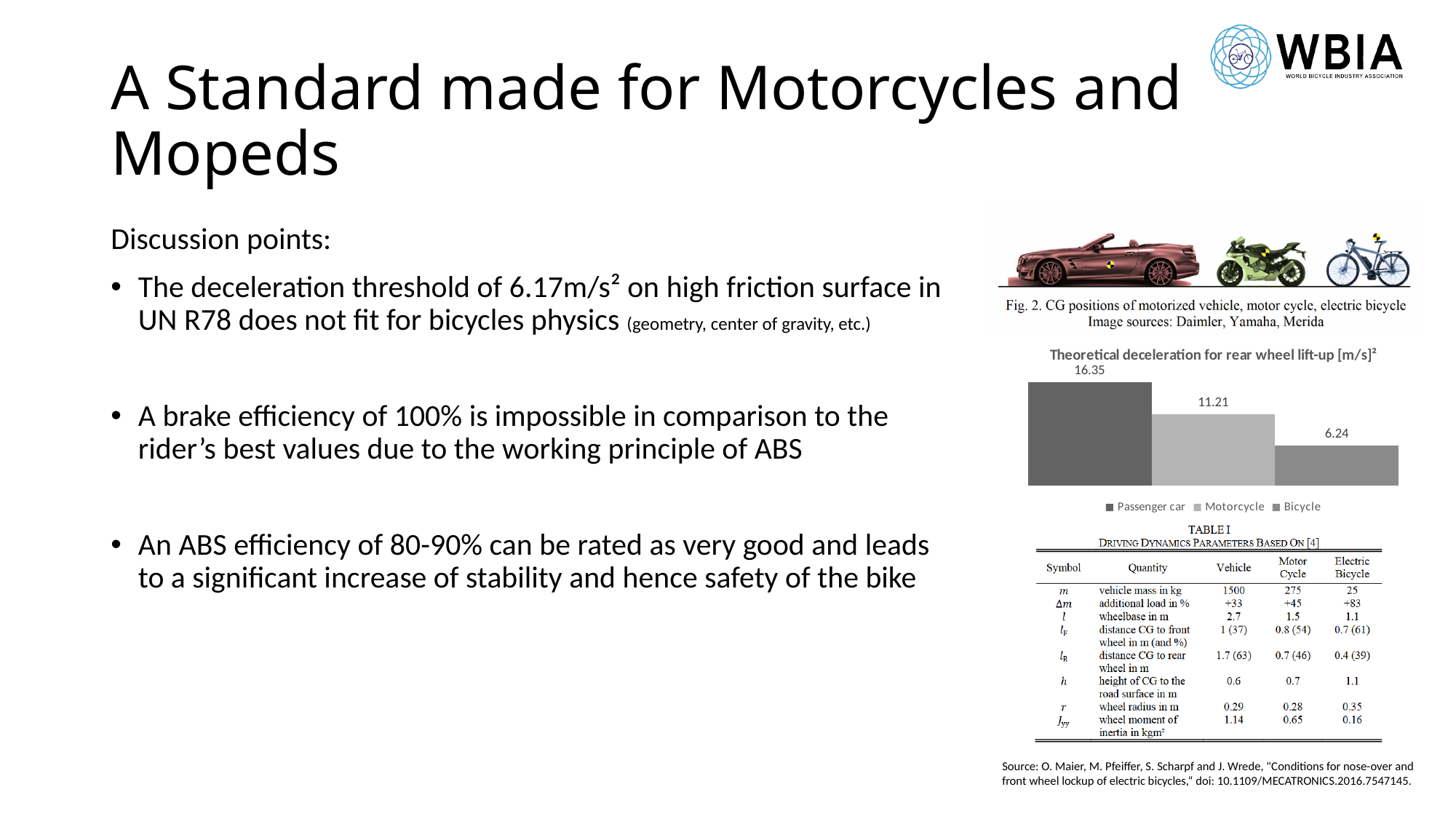
What is the theoretical deceleration for rear wheel lift-up for the bicycle? 6.24 How many bars are shown in the theoretical deceleration chart? 3 Which vehicle has the lowest theoretical deceleration for rear wheel lift-up? Bicycle What is the difference between the motorcycle and bicycle values for theoretical deceleration for rear wheel lift-up? 4.97 Which has a larger theoretical deceleration for rear wheel lift-up, the motorcycle or the bicycle? Motorcycle What is the theoretical deceleration for rear wheel lift-up for the passenger car? 16.35 What is the title of the chart on the slide? Theoretical deceleration for rear wheel lift-up [m/s]² What is the difference between the passenger car and bicycle values for theoretical deceleration for rear wheel lift-up? 10.11 How many entries does the legend of the theoretical deceleration chart list? 3 What kind of chart is used to show the theoretical deceleration for rear wheel lift-up? Bar chart Which vehicle has the highest theoretical deceleration for rear wheel lift-up? Passenger car What is the theoretical deceleration for rear wheel lift-up for the motorcycle? 11.21